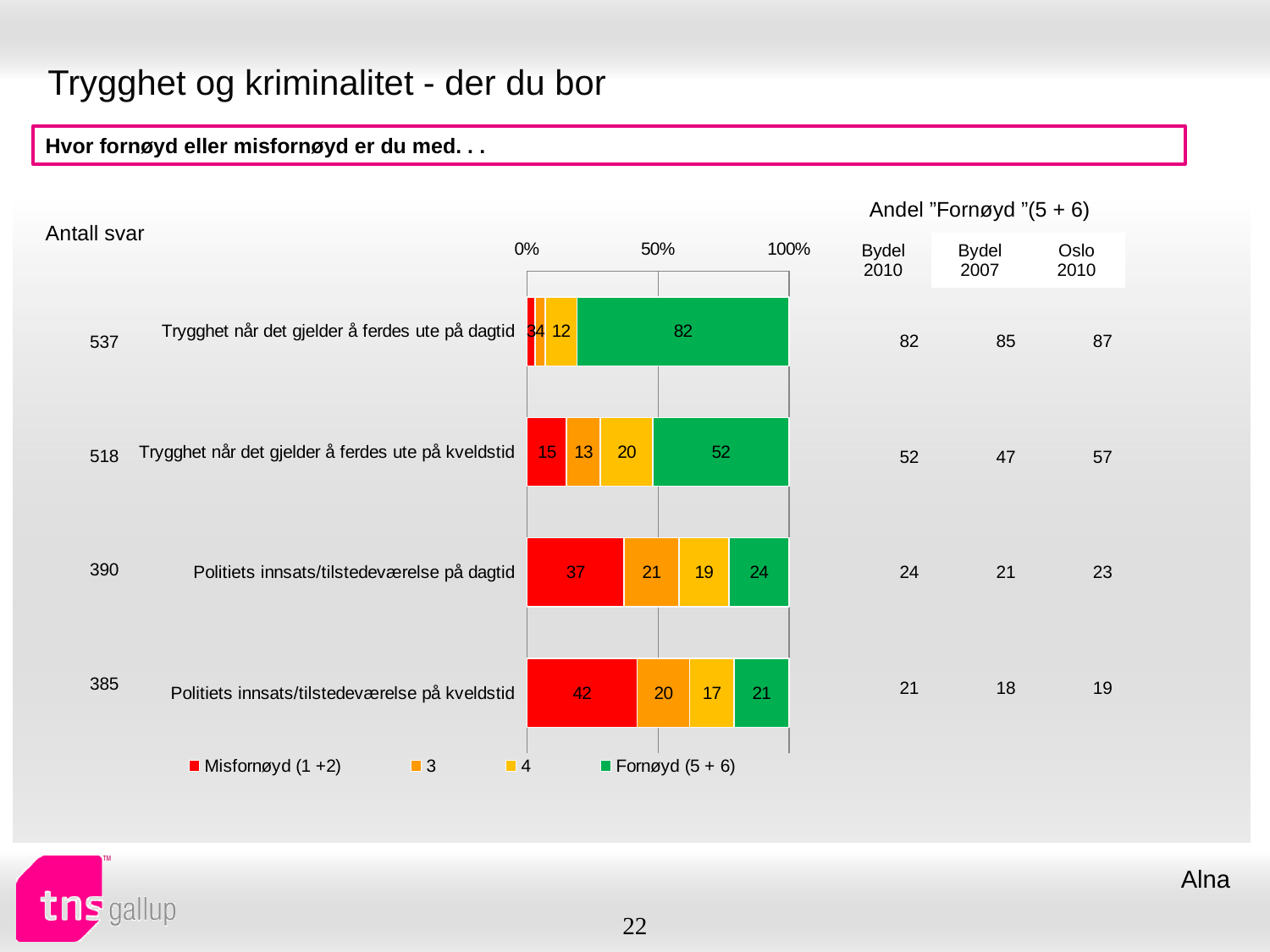
What is the difference between the 'Fornøyd (5 + 6)' values for 'Trygghet når det gjelder å ferdes ute på dagtid' and 'Trygghet når det gjelder å ferdes ute på kveldstid'? 30 How many categories are plotted in the chart? 4 Which colour represents 'Fornøyd (5 + 6)' in the chart? green What is the 'Misfornøyd (1 +2)' value for 'Politiets innsats/tilstedeværelse på kveldstid'? 42 Which is larger: the 'Misfornøyd (1 +2)' value for 'Politiets innsats/tilstedeværelse på dagtid' or for 'Politiets innsats/tilstedeværelse på kveldstid'? Politiets innsats/tilstedeværelse på kveldstid Which category has the lowest 'Fornøyd (5 + 6)' value? Politiets innsats/tilstedeværelse på kveldstid What kind of chart is shown on the slide? stacked bar chart How many series does the chart legend list? 4 What is the value of series '4' for 'Politiets innsats/tilstedeværelse på dagtid'? 19 What is the value of series '3' for 'Trygghet når det gjelder å ferdes ute på kveldstid'? 13 Which category has the highest 'Fornøyd (5 + 6)' value? Trygghet når det gjelder å ferdes ute på dagtid What is the 'Fornøyd (5 + 6)' value for 'Trygghet når det gjelder å ferdes ute på dagtid'? 82